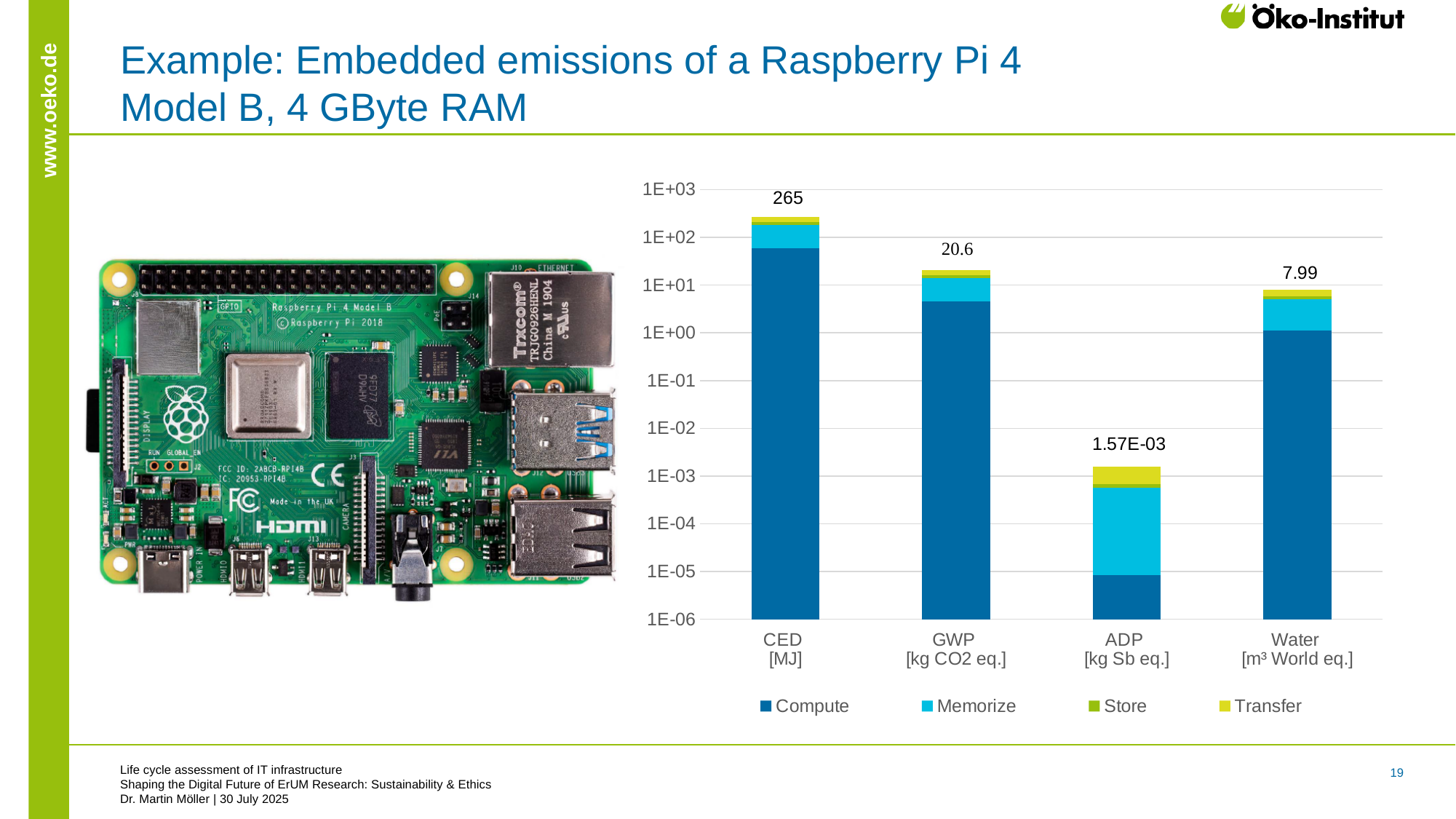
Which category has the highest labelled total? CED What is the total value labelled for the ADP bar? 1.57E-03 Which has the larger labelled total, GWP or Water? GWP How many categories are shown on the x axis? 4 What is the total value labelled for the Water bar? 7.99 What kind of chart is shown on the slide? Stacked bar chart What is the difference between the labelled totals of CED and GWP? 244.4 What is the total value labelled for the CED bar? 265 What is the total value labelled for the GWP bar? 20.6 Which category has the lowest labelled total? ADP How many series does the legend list? 4 Is the Compute segment of the CED bar greater or less than 1E+02? less